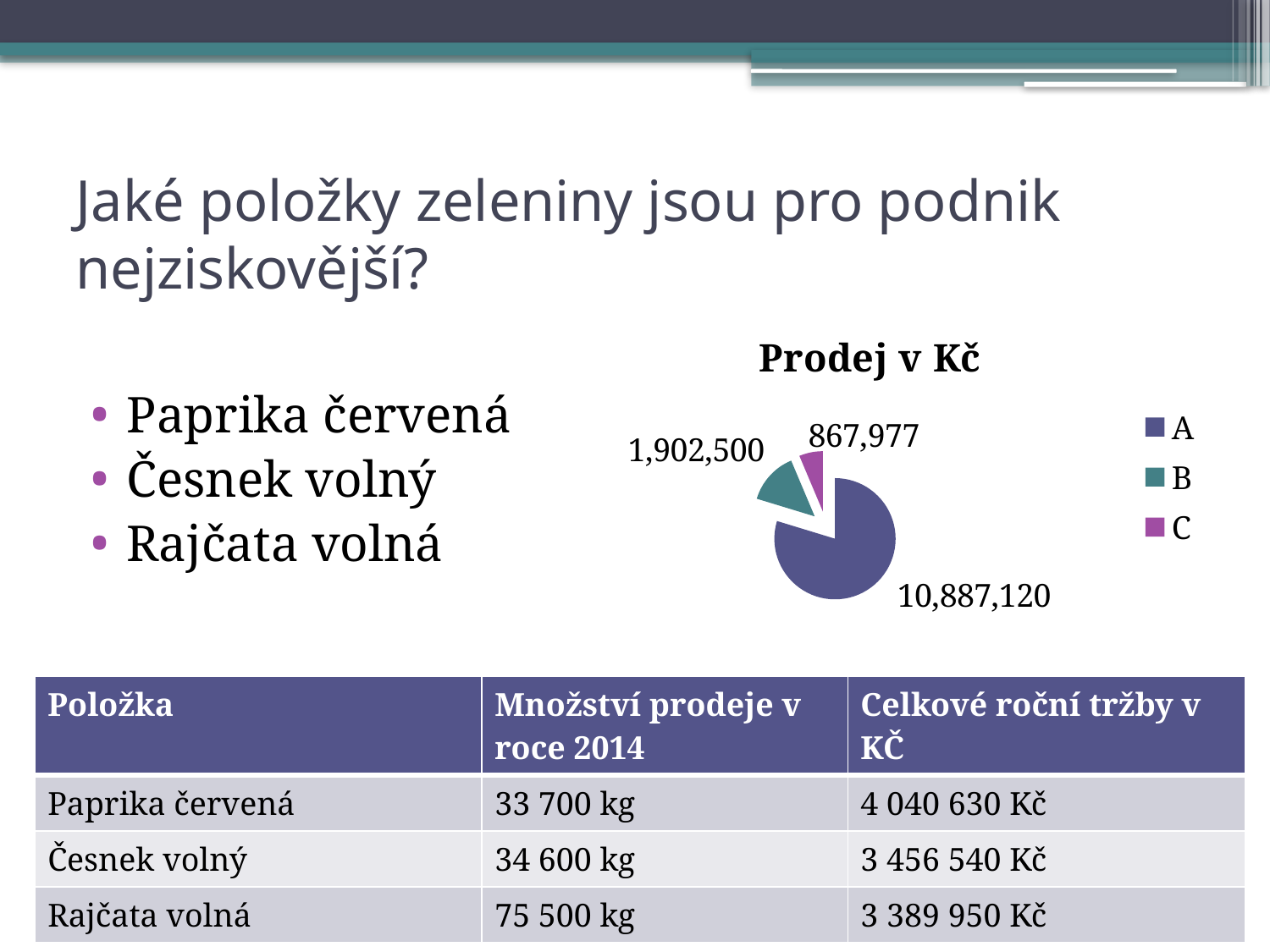
Which slice of the pie chart is the smallest? C What is the value for slice B in the pie chart? 1,902,500 Which slice of the pie chart is the largest? A How many entries does the chart legend list? 3 What is the difference between the values of slice A and slice B? 8,984,620 What is the value for slice A in the pie chart? 10,887,120 Which is larger, the value of slice B or the value of slice C? B How many slices does the pie chart have? 3 What is the value for slice C in the pie chart? 867,977 What kind of chart is shown on the slide? pie chart What is the title of the chart? Prodej v Kč What is the difference between the values of slice B and slice C? 1,034,523